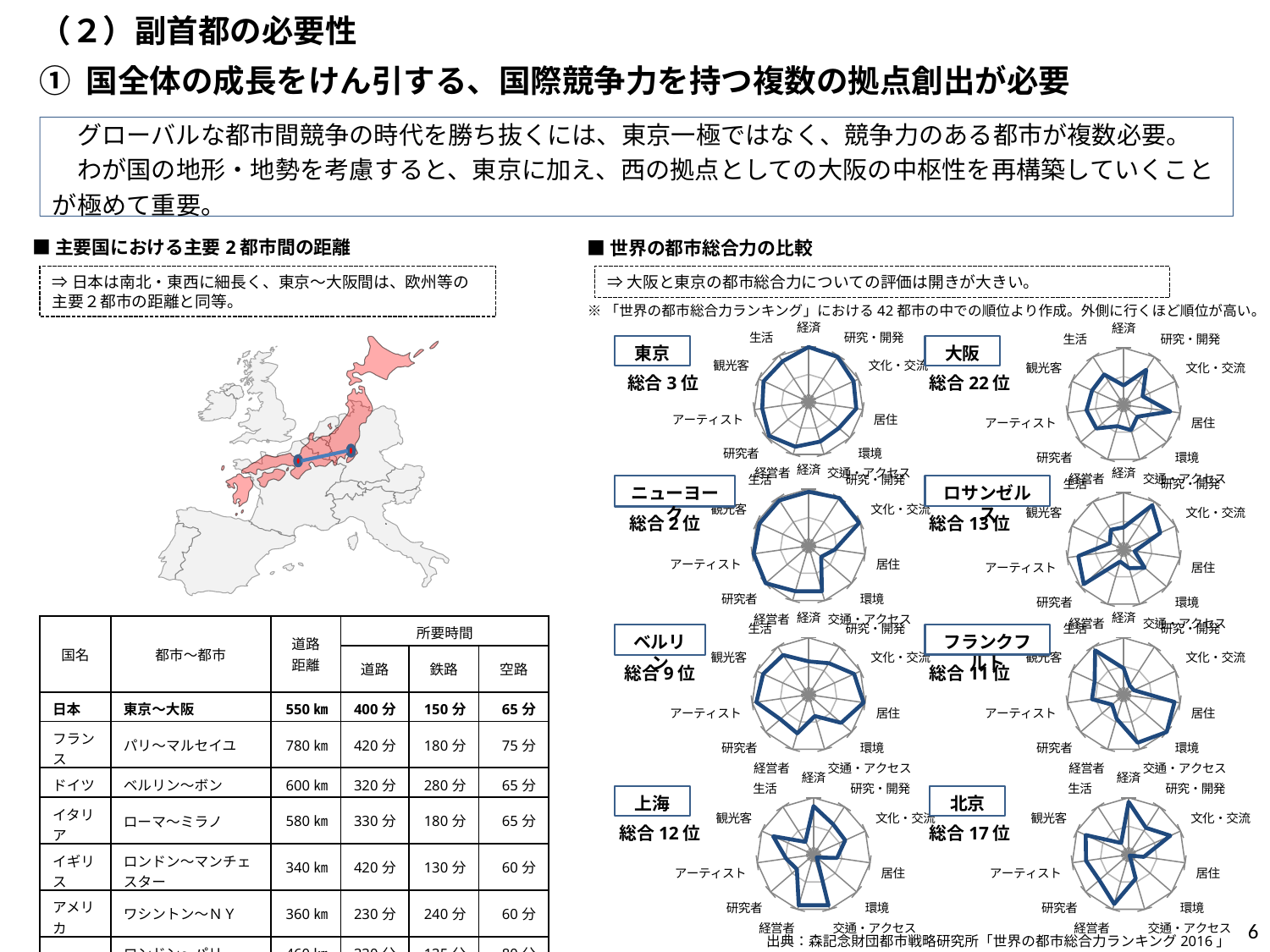
In the radar chart section, what overall rank (総合) is shown for ベルリン? 9位 Among the eight cities with radar charts, which has the best overall rank? ニューヨーク How many radar charts are shown on the slide? 8 In the radar chart section, what overall rank (総合) is shown for 北京? 17位 In the radar chart section, what overall rank (総合) is shown for 大阪? 22位 Comparing the 東京 and 大阪 radar charts, which city scores further out on the 経済 axis? 東京 In the radar chart section, what overall rank (総合) is shown for 東京? 3位 What is the title of the section containing the radar charts? 世界の都市総合力の比較 In the radar chart section, what overall rank (総合) is shown for ニューヨーク? 2位 What source is cited for the radar charts? 森記念財団都市戦略研究所「世界の都市総合力ランキング 2016」 What kind of chart is used to compare the cities' overall strength on the right side of the slide? Radar chart Among the eight cities with radar charts, which has the worst overall rank? 大阪